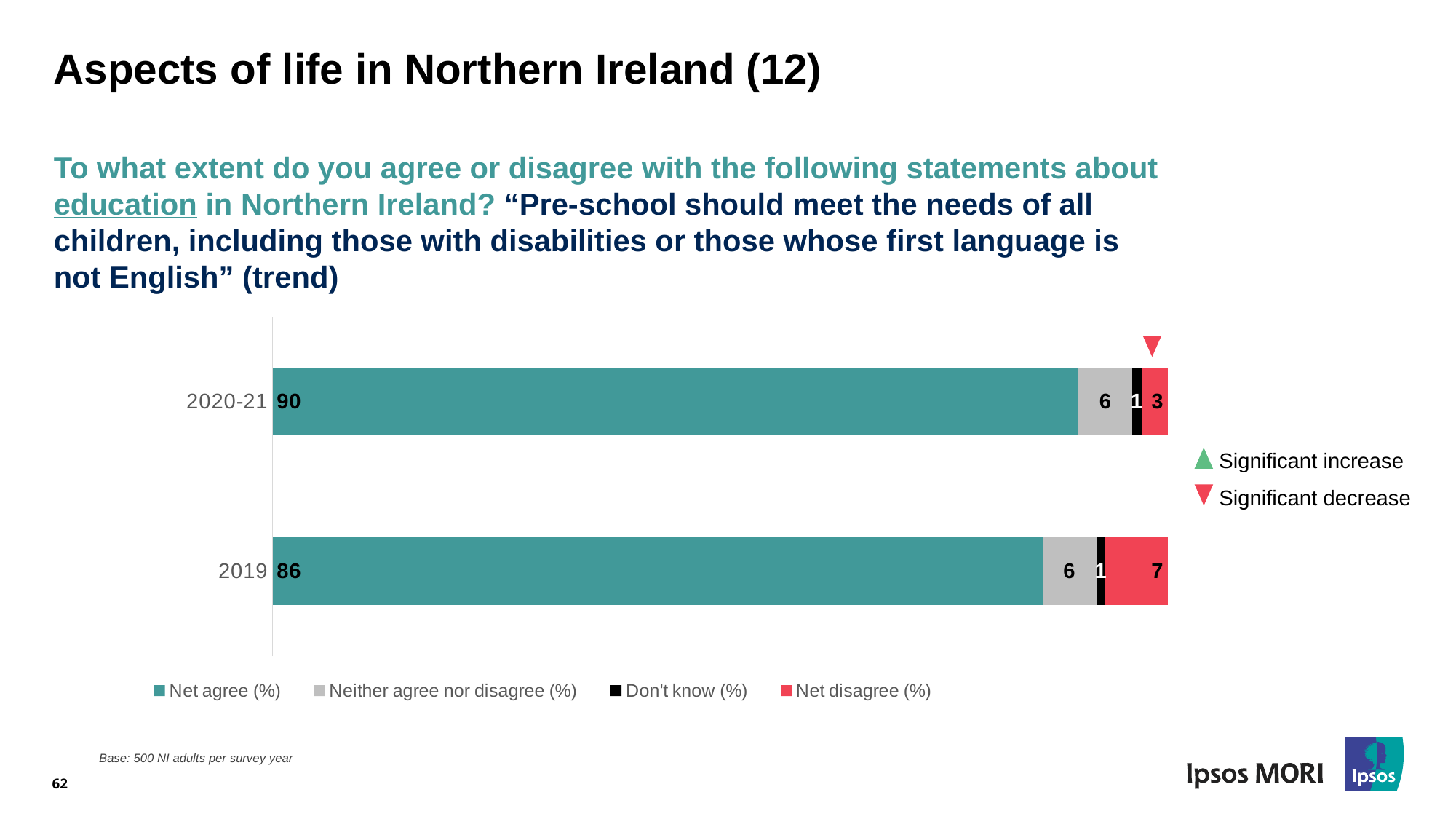
Which year has the lower Net disagree (%) value? 2020-21 What kind of chart is shown on the slide? Stacked bar chart How many survey years are shown in the chart? 2 What is the Don't know (%) value for 2020-21? 1 What is the difference in Net agree (%) between 2020-21 and 2019? 4 What is the total of the stacked bar for 2019? 100 What is the Net agree (%) value for 2020-21? 90 What is the Net disagree (%) value for 2019? 7 What is the Neither agree nor disagree (%) value for 2019? 6 Is the Net disagree (%) value larger for 2019 or for 2020-21? 2019 Which year has the higher Net agree (%) value? 2020-21 How many series does the legend list? 4